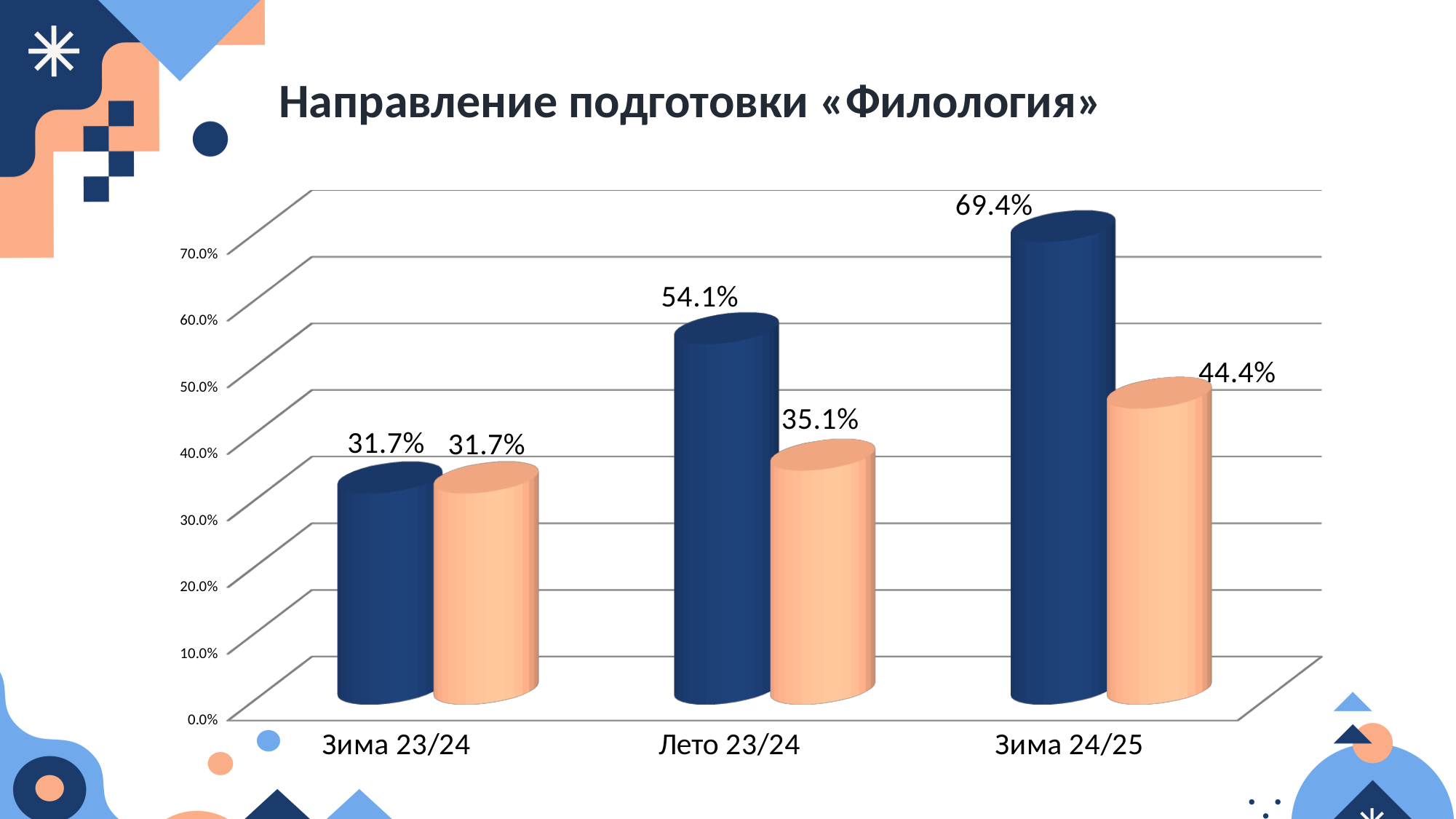
How many categories are shown on the x axis of the chart? 3 Do the dark blue bar values rise or fall from Зима 23/24 to Зима 24/25? Rise What is the value of the orange bar for Зима 24/25? 44.4% Which is larger for Зима 24/25: the dark blue bar or the orange bar? The dark blue bar What is the value of the orange bar for Лето 23/24? 35.1% What is the difference between the dark blue and orange bars for Лето 23/24? 19.0% Which category has the lowest orange bar? Зима 23/24 What type of chart is shown on the slide? Bar chart Which category has the highest dark blue bar? Зима 24/25 What is the title of the chart on the slide? Направление подготовки «Филология» What is the value of the dark blue bar for Зима 23/24? 31.7% What is the value of the dark blue bar for Зима 24/25? 69.4%